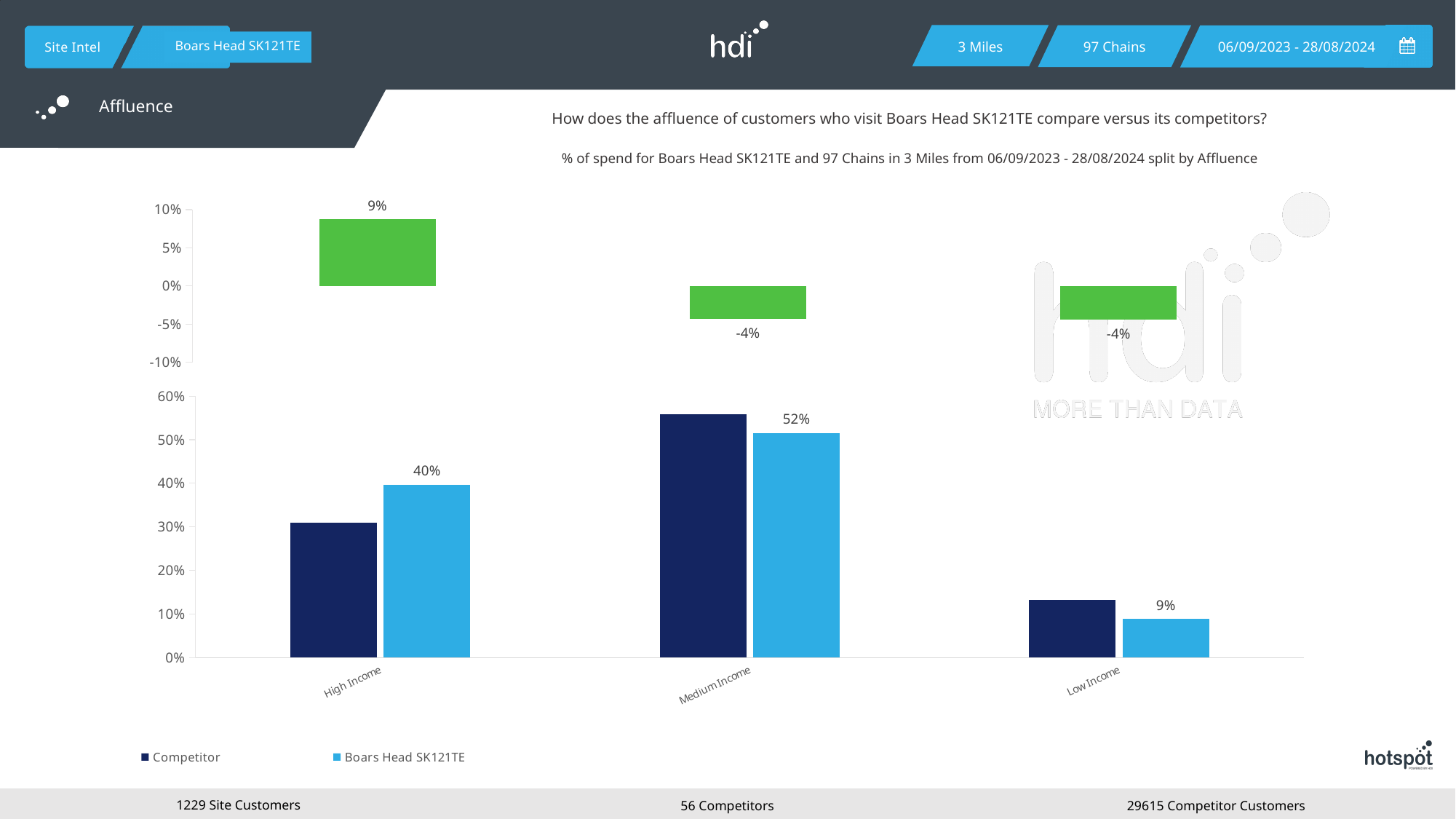
In the bottom bar chart, which affluence category has the lowest Boars Head SK121TE value? Low Income In the bottom bar chart, is the Competitor value for Medium Income greater or less than 50%? greater In the bottom bar chart, for High Income, which is larger: the Competitor bar or the Boars Head SK121TE bar? Boars Head SK121TE In the bottom bar chart, is the Competitor value for Low Income greater or less than 20%? less How many series does the legend of the bottom bar chart list? 2 In the bottom bar chart, what is the Boars Head SK121TE value for Low Income? 9% In the bottom bar chart, which affluence category has the highest Boars Head SK121TE value? Medium Income In the bottom bar chart, what is the difference between the Boars Head SK121TE values for Medium Income and High Income? 12% In the top difference chart, what is the value shown for High Income? 9% In the bottom bar chart, what is the Boars Head SK121TE value for High Income? 40% In the bottom bar chart, what is the Boars Head SK121TE value for Medium Income? 52% In the top difference chart, what is the value shown for Medium Income? -4%